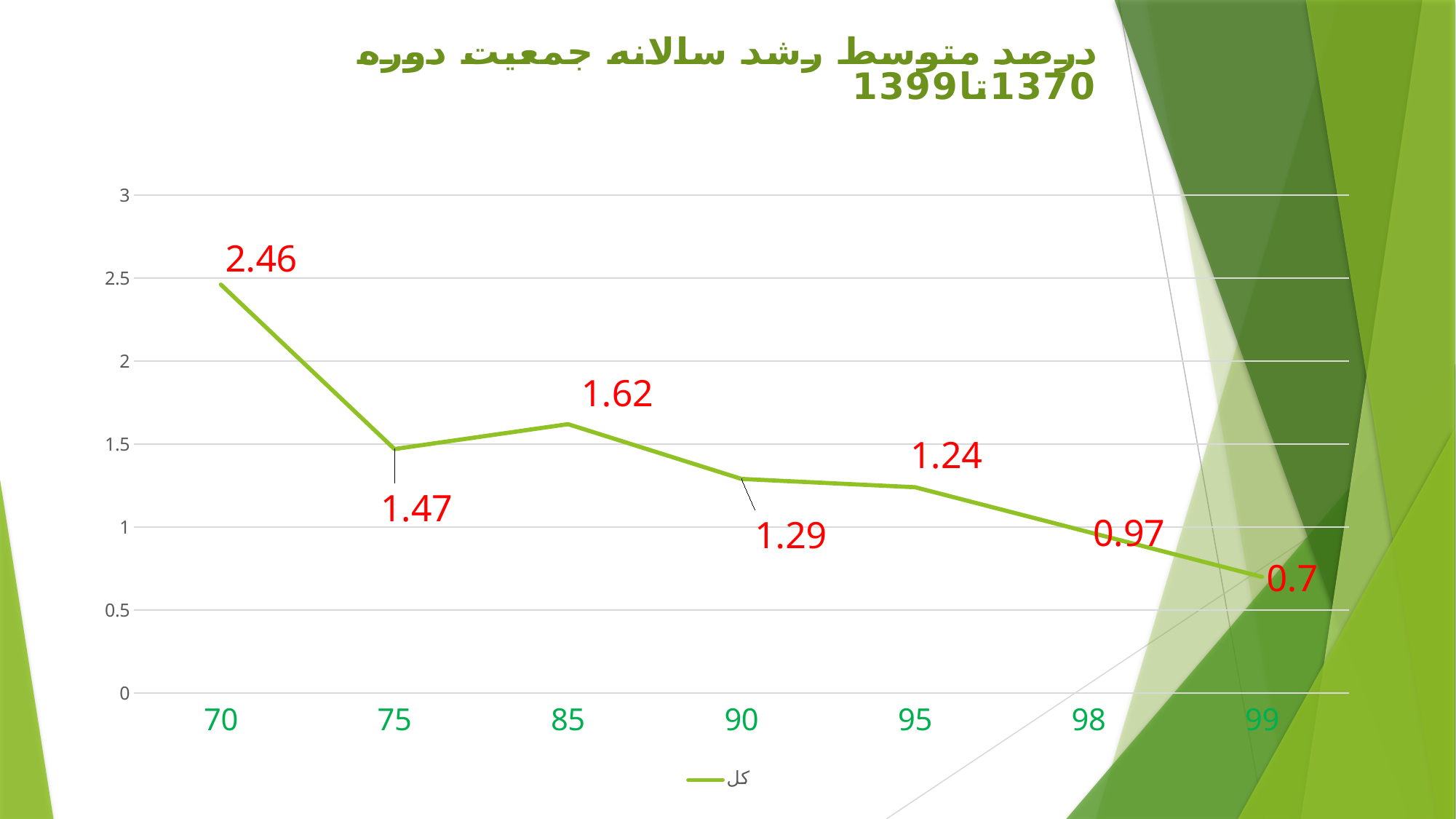
What is the value for 98? 0.97 How many points are plotted on the line? 7 Do the values generally rise or fall from 70 to 99? fall What is the value for 99? 0.7 How many series does the legend list? 1 What is the value for 70? 2.46 Which category has the highest value? 70 Which category has the lowest value? 99 What is the difference between the values for 70 and 75? 0.99 What kind of chart is shown on the slide? line chart What is the value for 85? 1.62 Which is larger, the value for 75 or the value for 85? 85